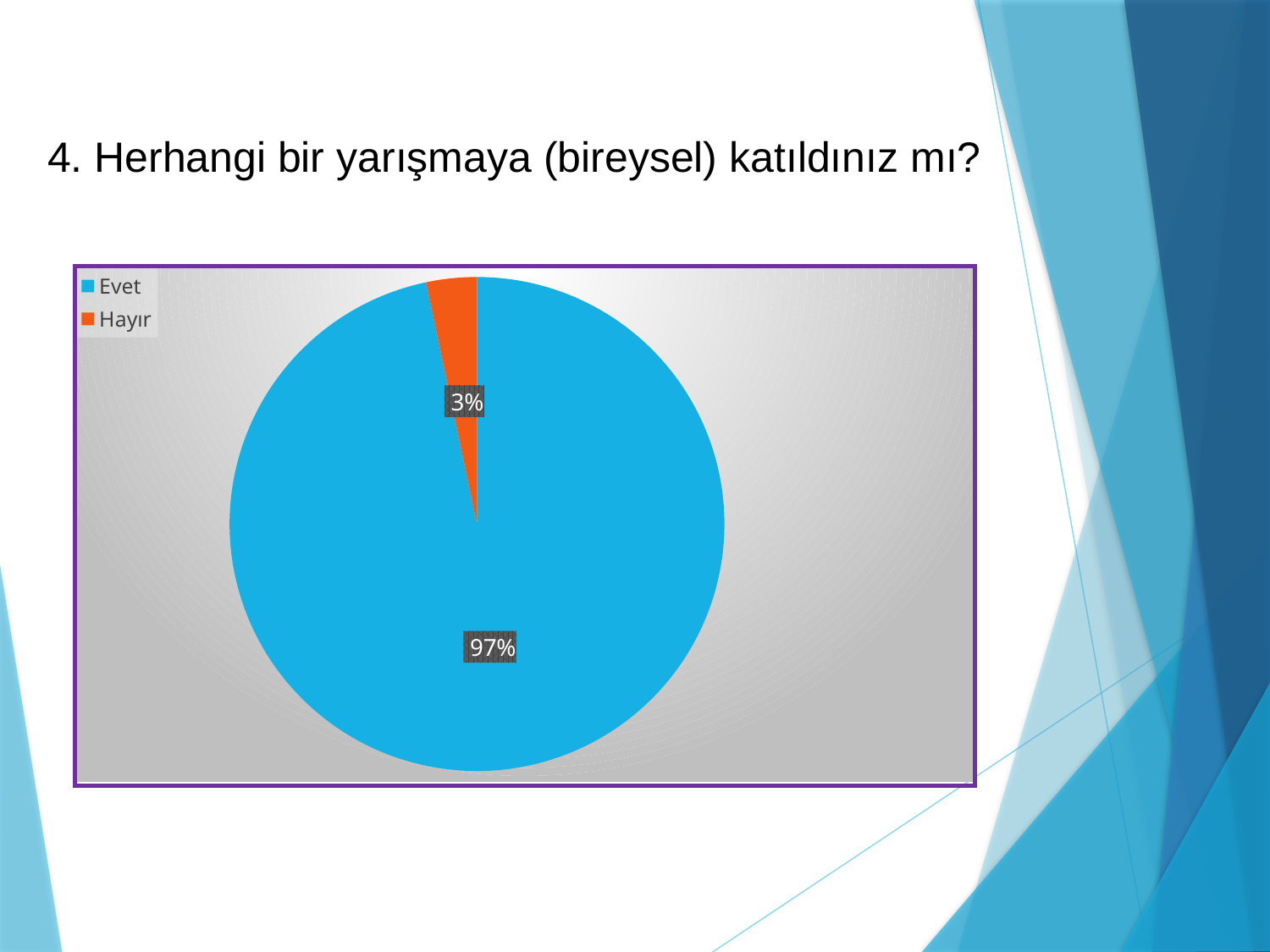
Which category has the smallest slice of the pie? Hayır What colour is the Hayır slice? orange What share of the pie does Evet have? 97% What is the question text shown above the chart? 4. Herhangi bir yarışmaya (bireysel) katıldınız mı? How many categories does the pie chart have? 2 What is the difference in percentage points between Evet and Hayır? 94 Which is larger, the share for Evet or the share for Hayır? Evet How many entries does the legend list? 2 What share of the pie does Hayır have? 3% Which category has the largest slice of the pie? Evet What kind of chart is shown on the slide? pie chart